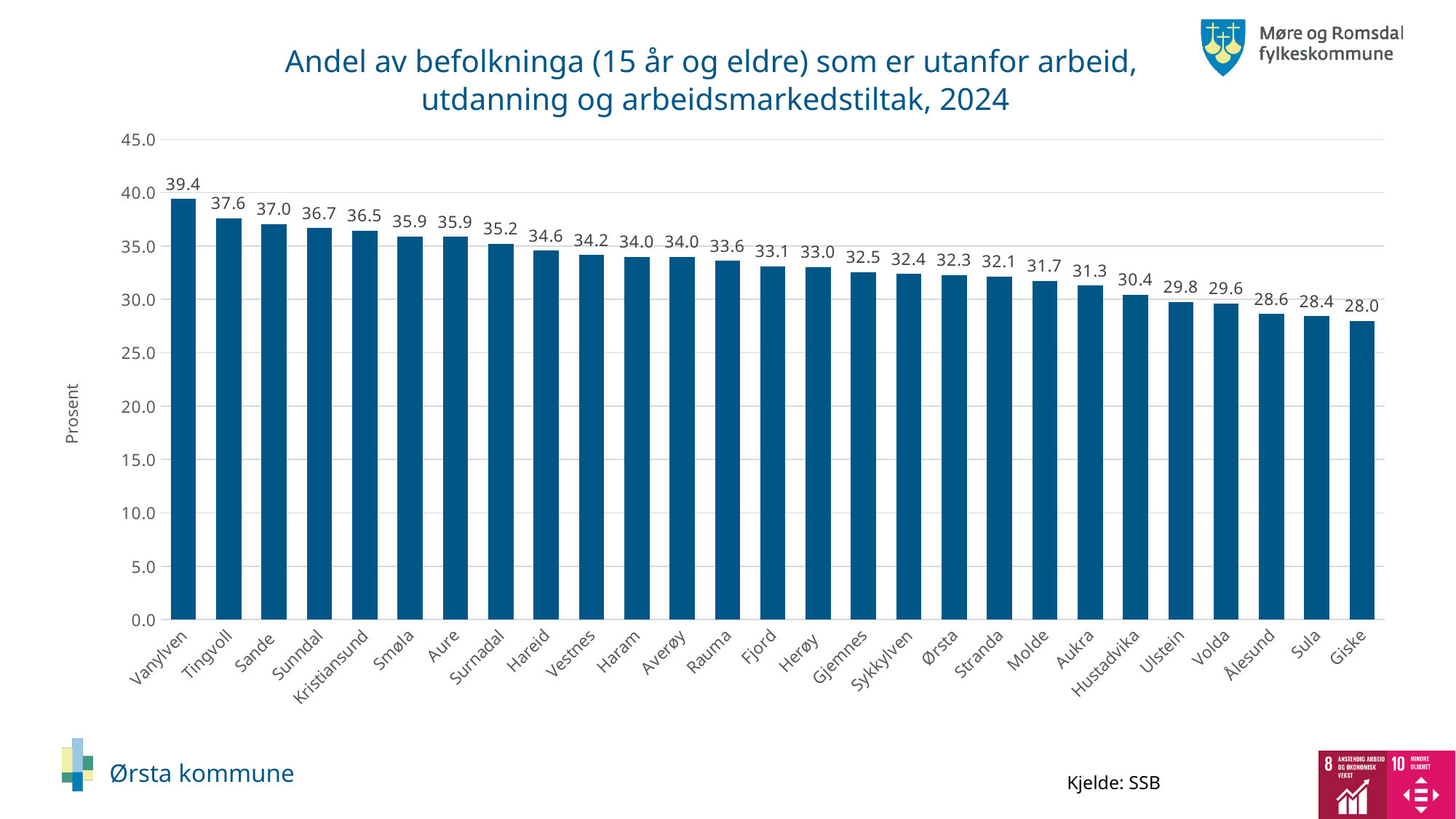
What is the value for Molde? 31.7 What is the value for Ørsta? 32.3 Which municipality has the highest value? Vanylven Which municipality has the lowest value? Giske Which is larger, the value for Tingvoll or the value for Ålesund? Tingvoll What is the label on the vertical axis? Prosent How many municipalities are shown in the chart? 27 What is the difference between the values for Vanylven and Giske? 11.4 What kind of chart is shown on the slide? bar chart What is the difference between the values for Ørsta and Volda? 2.7 Is the value for Hustadvika greater or less than 35.0? less What is the value for Kristiansund? 36.5